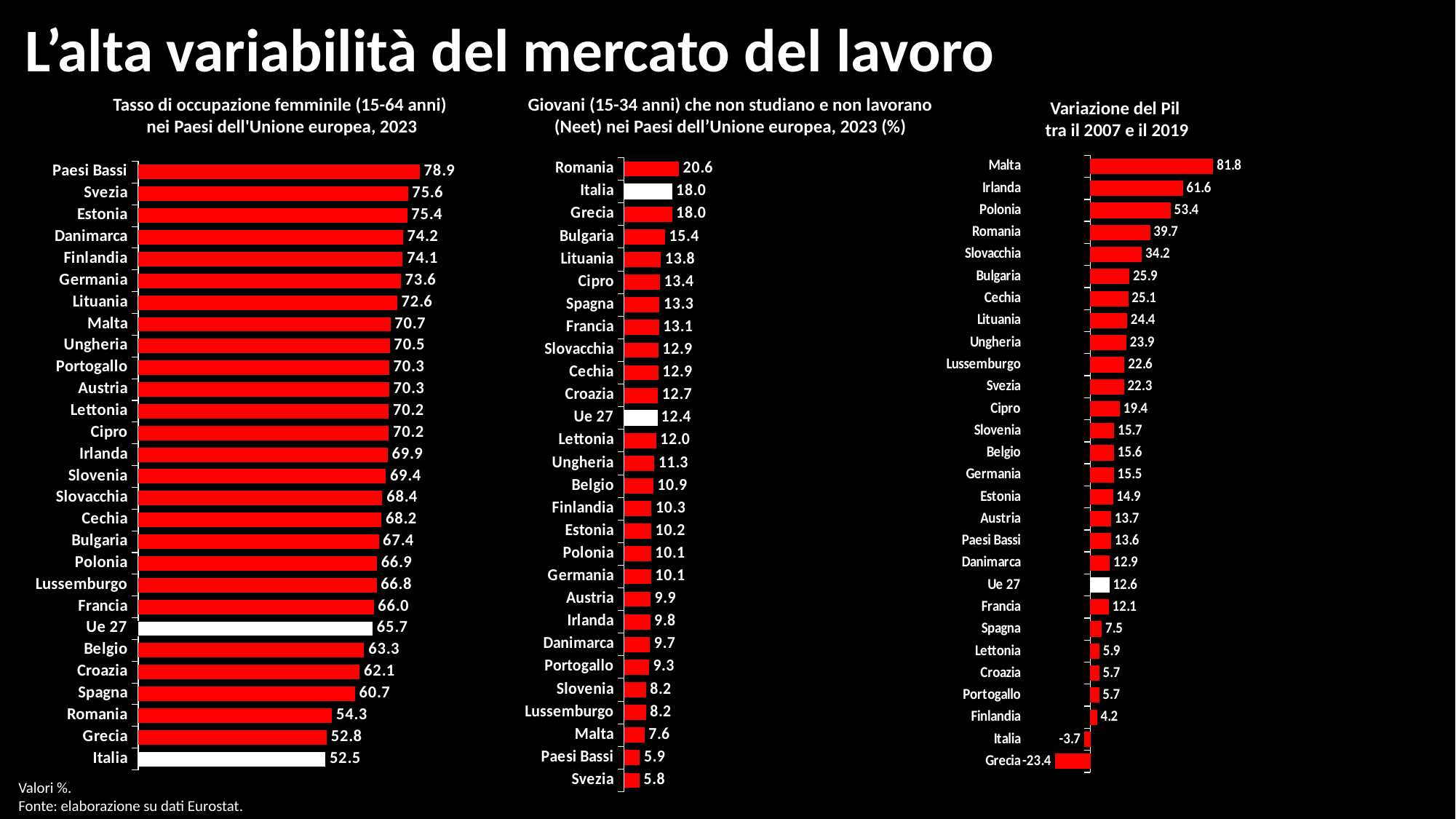
What kind of chart is the chart 'Variazione del Pil tra il 2007 e il 2019'? Bar chart In the chart 'Giovani (15-34 anni) che non studiano e non lavorano (Neet)', which country has the lowest value? Svezia In the chart 'Variazione del Pil tra il 2007 e il 2019', what is the difference between Malta and Irlanda? 20.2 In the chart 'Variazione del Pil tra il 2007 e il 2019', which country has the highest value? Malta In the chart 'Tasso di occupazione femminile (15-64 anni)', what is the difference between Paesi Bassi and Italia? 26.4 In the chart 'Variazione del Pil tra il 2007 e il 2019', what is the value for Grecia? -23.4 In the chart 'Tasso di occupazione femminile (15-64 anni)', which country has the highest value? Paesi Bassi In the chart 'Giovani (15-34 anni) che non studiano e non lavorano (Neet)', which country has the highest value? Romania In the chart 'Tasso di occupazione femminile (15-64 anni)', what is the value for Ue 27? 65.7 In the chart 'Giovani (15-34 anni) che non studiano e non lavorano (Neet)', which is larger, Francia or Spagna? Spagna In the chart 'Giovani (15-34 anni) che non studiano e non lavorano (Neet)', what is the value for Italia? 18.0 In the chart 'Tasso di occupazione femminile (15-64 anni)', what is the value for Italia? 52.5